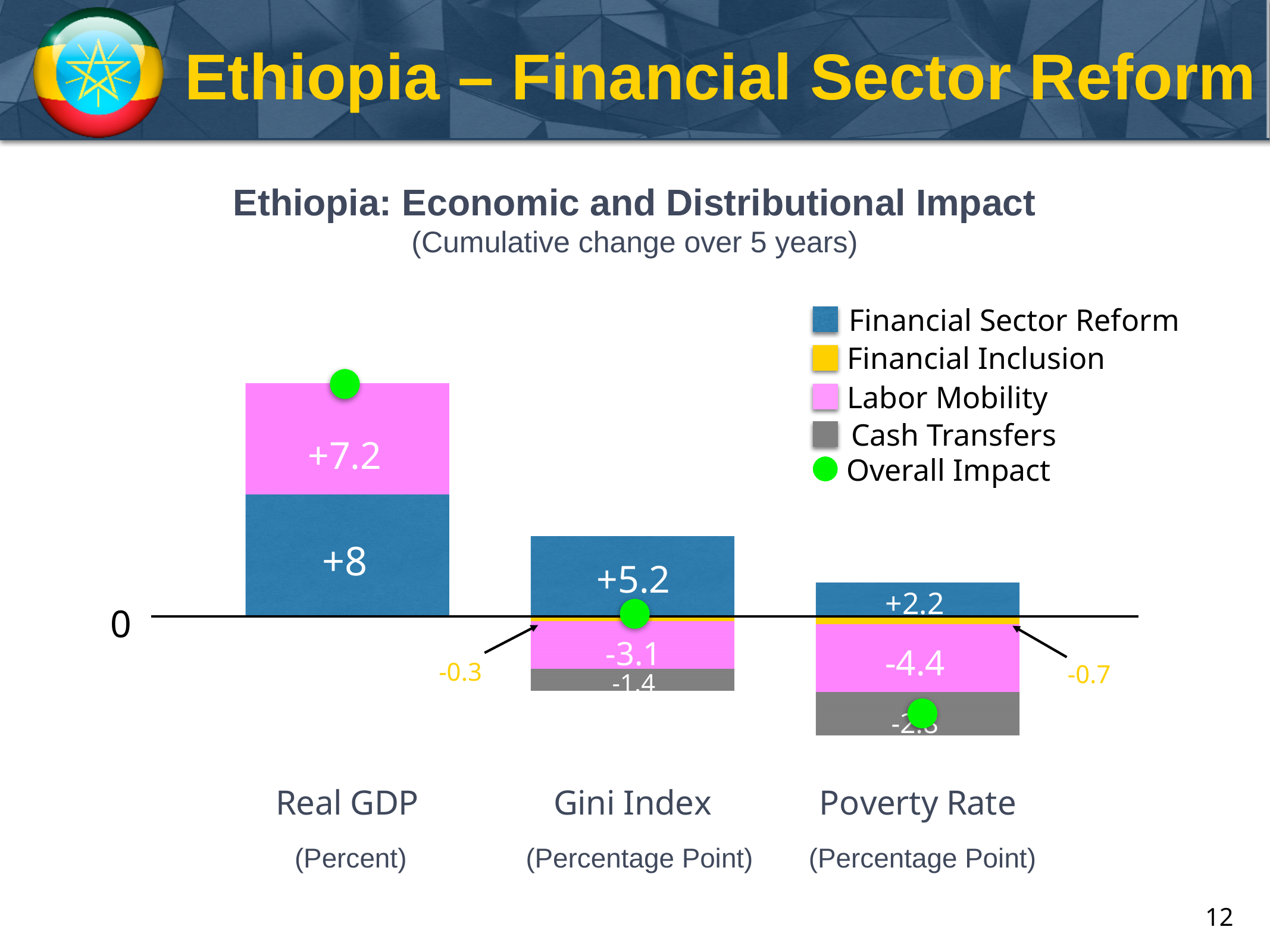
What is the difference between the Financial Sector Reform contribution for Real GDP and for the Gini Index? 2.8 What is the Financial Sector Reform contribution for the Gini Index? +5.2 What is the Financial Inclusion contribution for the Poverty Rate? -0.7 Which category has the largest Financial Sector Reform contribution? Real GDP What is the Labor Mobility contribution for the Poverty Rate? -4.4 What is the Labor Mobility contribution for Real GDP? +7.2 How many categories are shown on the x axis? 3 What kind of chart is shown on the slide? Stacked bar chart How many entries does the legend list? 5 What is the Labor Mobility contribution for the Gini Index? -3.1 What is the Cash Transfers contribution for the Gini Index? -1.4 What is the Financial Sector Reform contribution for Real GDP? +8